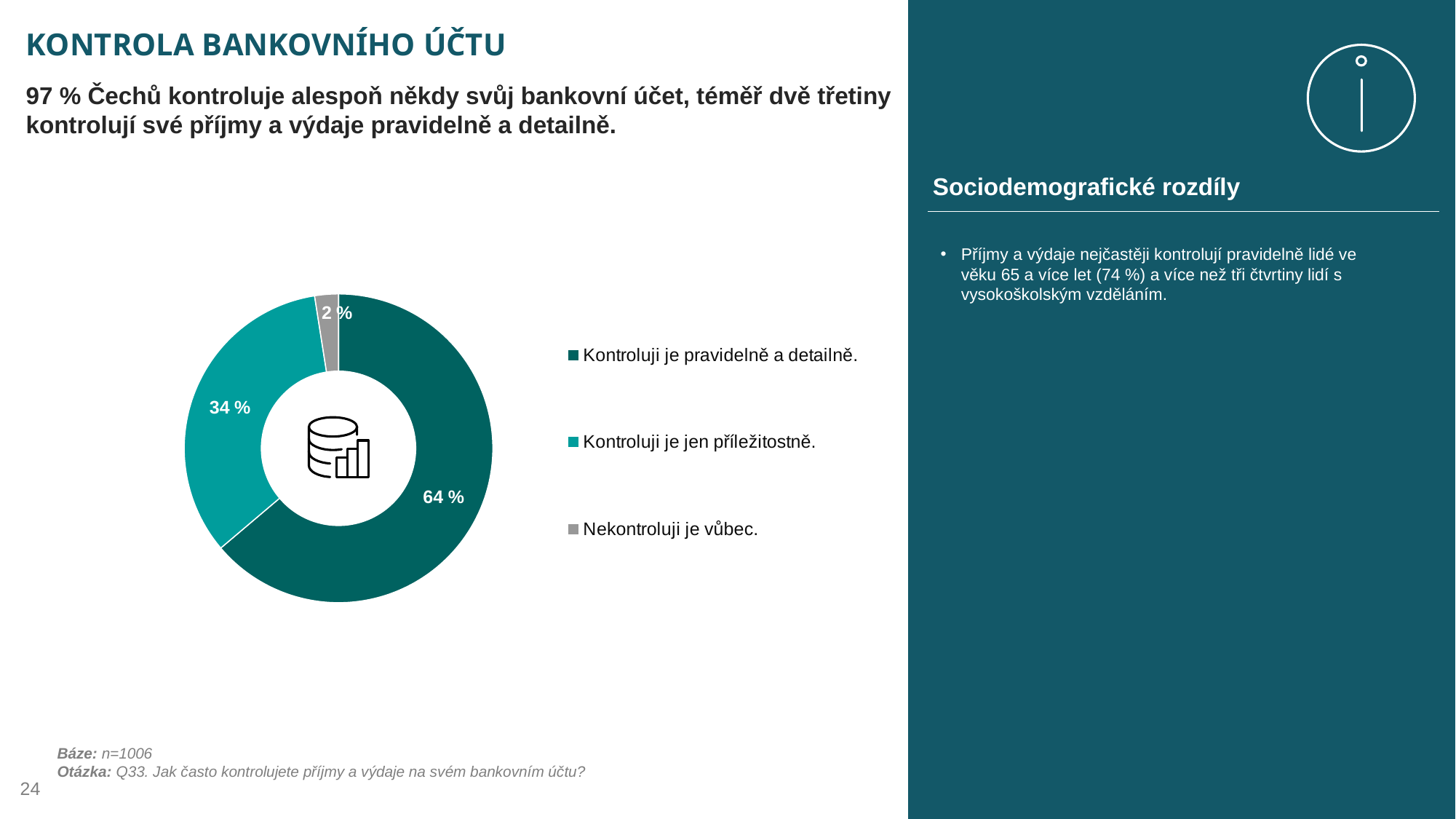
Which category has the largest share of the pie? Kontroluji je pravidelně a detailně. What is the combined share of the two categories in which respondents check their account at least sometimes? 98 % What is the base (n) stated for the chart? n=1006 What colour is the slice for "Nekontroluji je vůbec."? Grey How many categories does the pie chart show? 3 What share of respondents answered "Kontroluji je pravidelně a detailně."? 64 % What kind of chart is shown on the slide? Pie chart (doughnut) Which category has the smallest share of the pie? Nekontroluji je vůbec. What is the difference in percentage points between "Kontroluji je pravidelně a detailně." and "Kontroluji je jen příležitostně."? 30 percentage points What share of respondents answered "Nekontroluji je vůbec."? 2 % Which is larger: the share for "Kontroluji je jen příležitostně." or for "Nekontroluji je vůbec."? Kontroluji je jen příležitostně. What share of respondents answered "Kontroluji je jen příležitostně."? 34 %